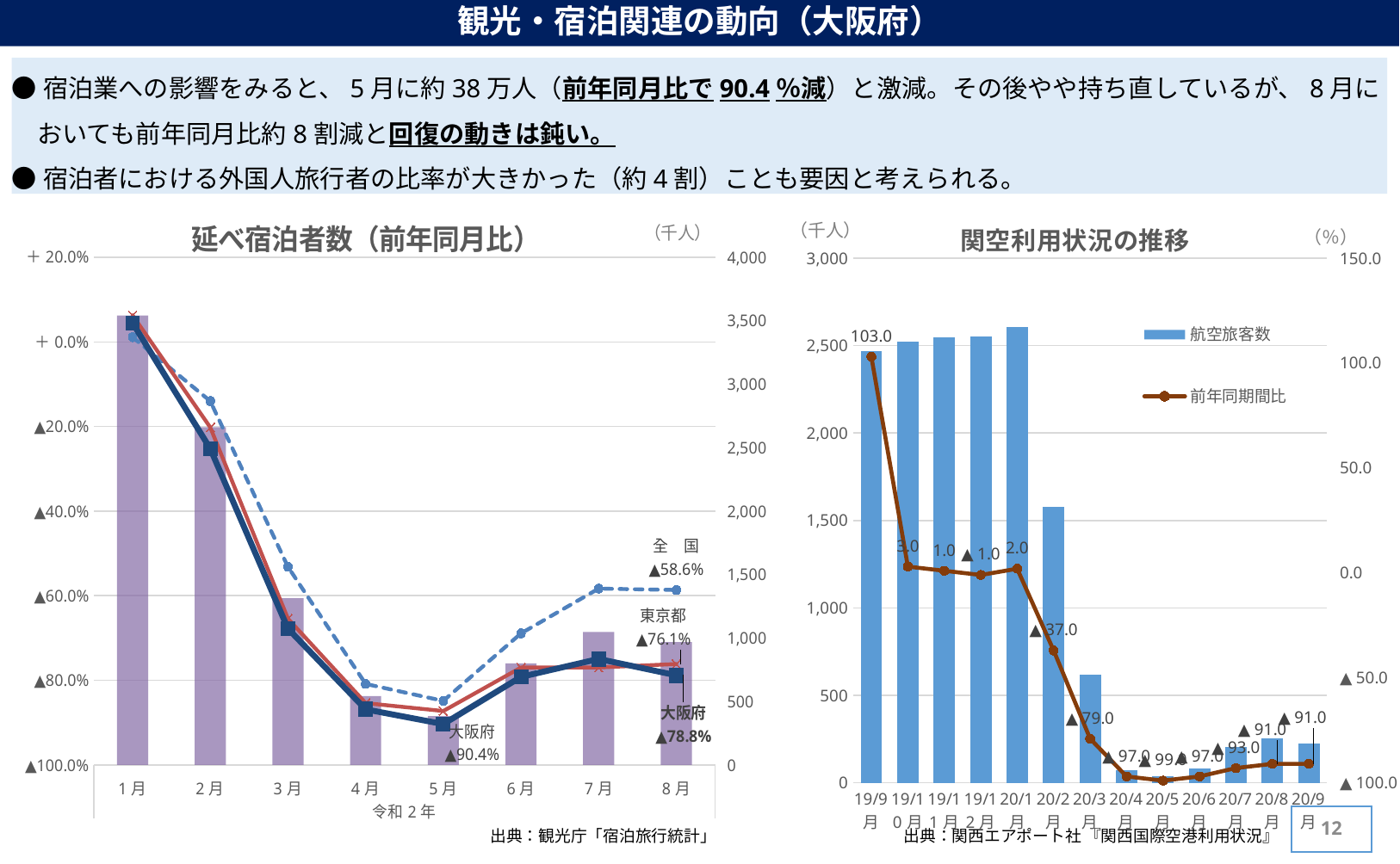
In the left chart 延べ宿泊者数（前年同月比）, what is the value for 大阪府 in 5月? ▲90.4% In the left chart 延べ宿泊者数（前年同月比）, what is the value for 大阪府 in 8月? ▲78.8% In the right chart 関空利用状況の推移, what is the 前年同期間比 value for 19/9月? 103.0 In the right chart 関空利用状況の推移, is the 航空旅客数 value for 20/5月 greater or less than 500? less In the left chart 延べ宿泊者数（前年同月比）, how many months are shown on the x axis? 8 In the left chart 延べ宿泊者数（前年同月比）, by how many percentage points does the 大阪府 value in 8月 (▲78.8%) differ from its value in 5月 (▲90.4%)? 11.6 In the left chart 延べ宿泊者数（前年同月比）, does the 大阪府 line rise or fall from 1月 to 5月? fall In the left chart 延べ宿泊者数（前年同月比）, which shows the smaller decline in 8月, 全国 or 大阪府? 全国 In the left chart 延べ宿泊者数（前年同月比）, what is the value for 全国 in 8月? ▲58.6% In the right chart 関空利用状況の推移, what is the 前年同期間比 value for 20/3月? ▲79.0 In the right chart 関空利用状況の推移, which month has the lowest 前年同期間比 value? 20/5月 In the right chart 関空利用状況の推移, how many series does the legend list? 2